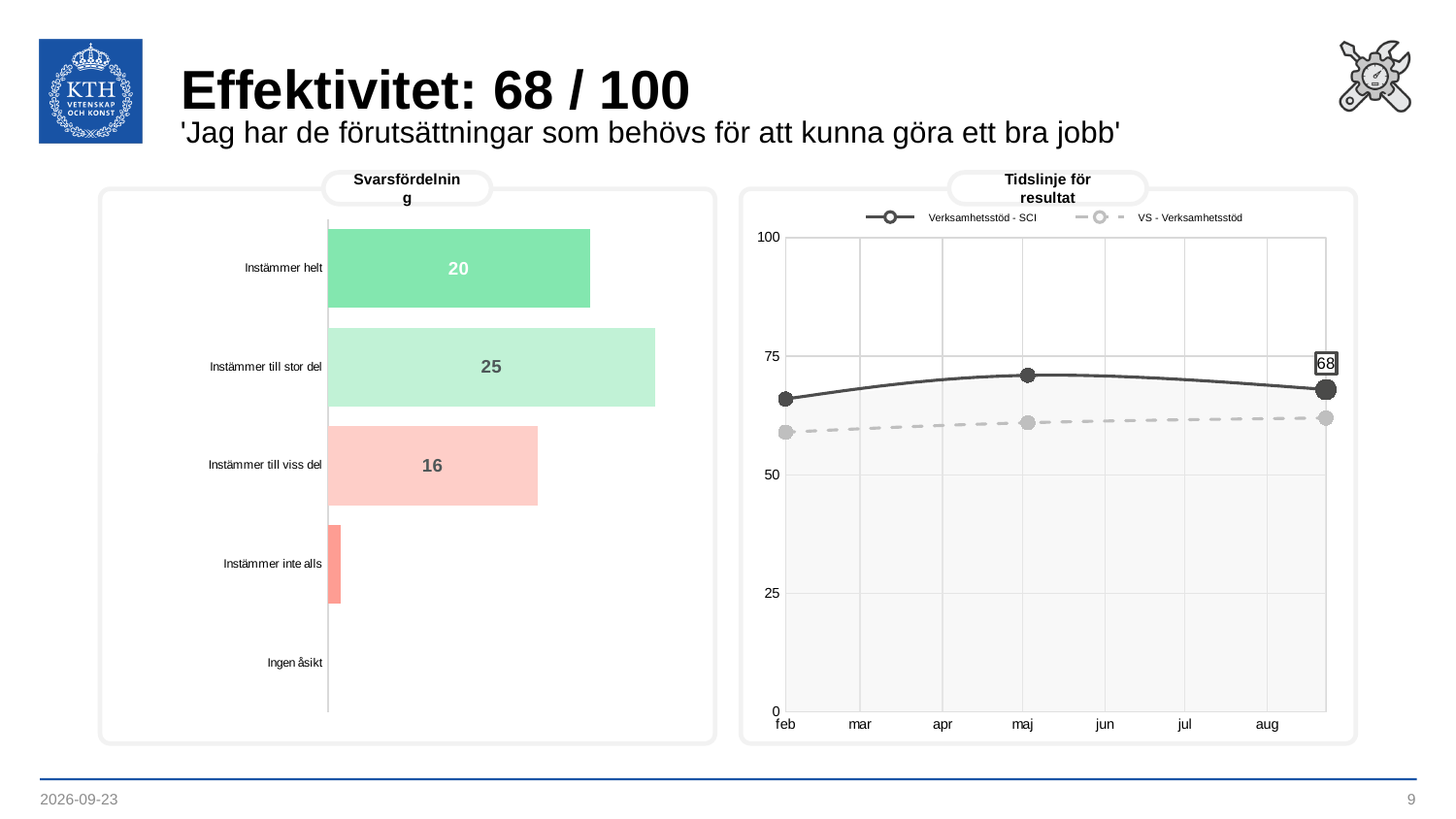
In the 'Svarsfördelning' chart, what is the difference between 'Instämmer till stor del' and 'Instämmer helt'? 5 How many series does the legend of the 'Tidslinje för resultat' chart list? 2 In the 'Tidslinje för resultat' chart, is the value for 'VS - Verksamhetsstöd' in feb greater or less than 75? less What kind of chart is the 'Svarsfördelning' chart? bar chart In the 'Svarsfördelning' chart, what is the value for 'Instämmer helt'? 20 In the 'Svarsfördelning' chart, what is the value for 'Instämmer till stor del'? 25 In the 'Svarsfördelning' chart, what is the value for 'Instämmer till viss del'? 16 In the 'Tidslinje för resultat' chart, what is the labelled final value of the 'Verksamhetsstöd - SCI' series? 68 How many categories are shown in the 'Svarsfördelning' chart? 5 In the 'Tidslinje för resultat' chart, which series has the higher value in maj: 'Verksamhetsstöd - SCI' or 'VS - Verksamhetsstöd'? Verksamhetsstöd - SCI In the 'Svarsfördelning' chart, which is larger: 'Instämmer helt' or 'Instämmer till viss del'? Instämmer helt In the 'Svarsfördelning' chart, which category has the highest value? Instämmer till stor del